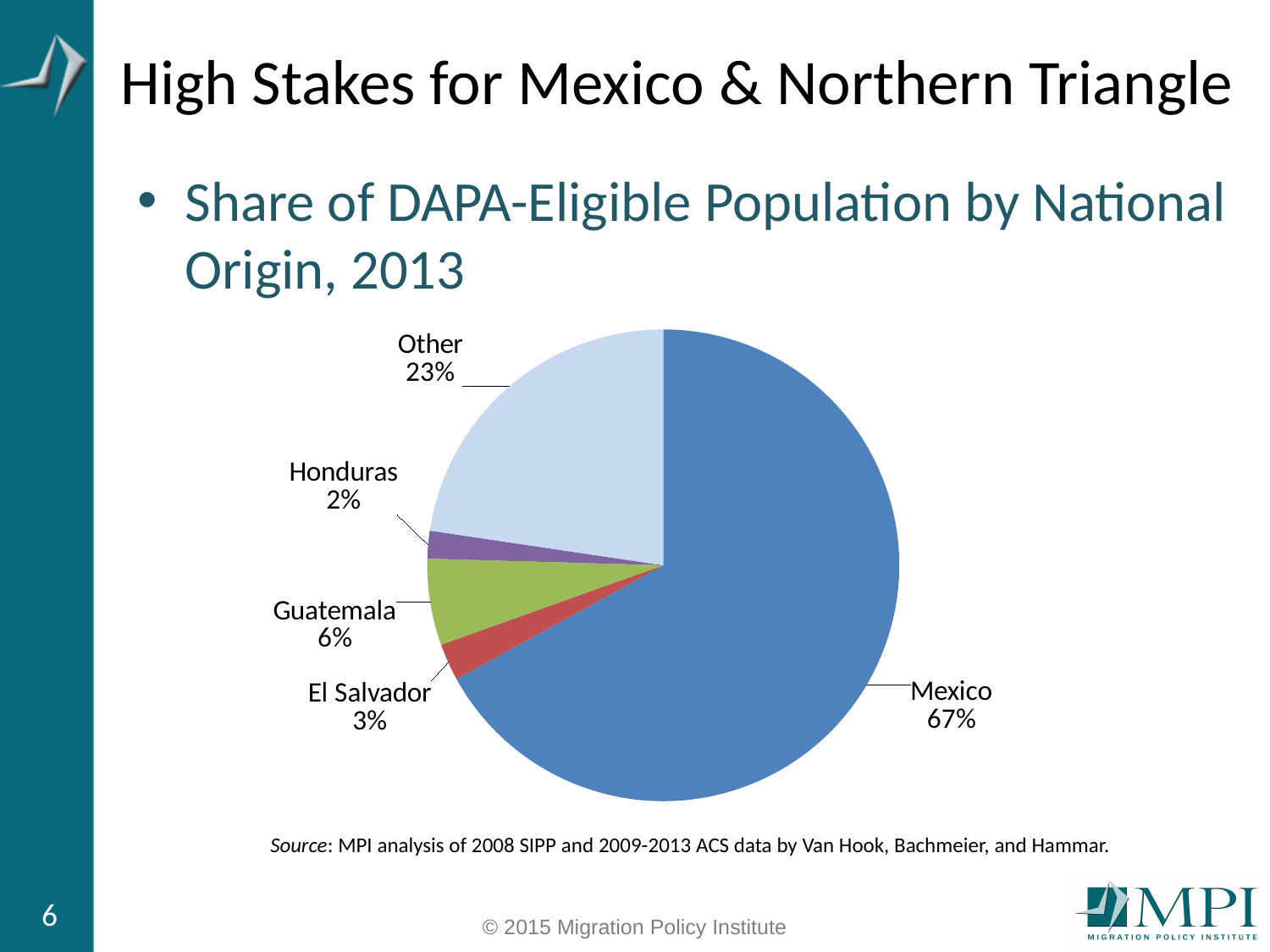
What share of the DAPA-eligible population is from El Salvador? 3% What share of the DAPA-eligible population is from Honduras? 2% Which has a larger share, Guatemala or El Salvador? Guatemala What is the difference in percentage points between the Mexico share and the Other share? 44 What share of the DAPA-eligible population is from Guatemala? 6% What share of the DAPA-eligible population is labelled Other? 23% What is the combined share of Guatemala, El Salvador and Honduras? 11% Which national origin has the largest share of the DAPA-eligible population? Mexico How many slices does the pie chart have? 5 What kind of chart is shown on the slide? pie chart Which national origin has the smallest share of the DAPA-eligible population? Honduras What share of the DAPA-eligible population is from Mexico? 67%